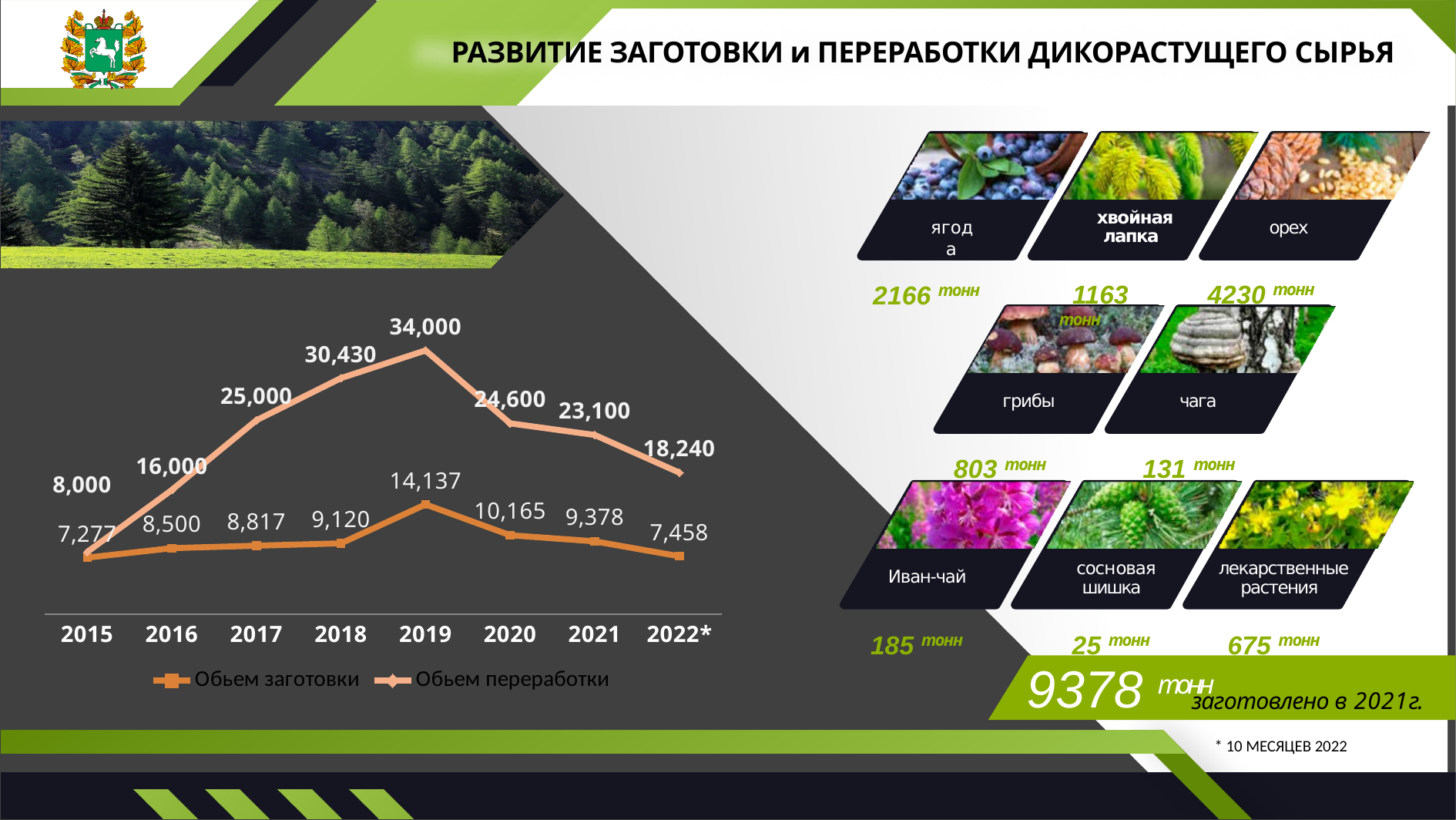
In which year is Объем заготовки highest? 2019 How many years are shown on the x axis of the chart? 8 How many series does the chart legend list? 2 What type of chart is shown on the slide? line chart Which is larger in 2016: Объем заготовки or Объем переработки? Объем переработки What is the difference in Объем заготовки between 2015 and 2018? 1,843 What is the difference between Объем переработки and Объем заготовки in 2019? 19,863 What is the value of Объем переработки in 2019? 34,000 What is the value of Объем переработки in 2022*? 18,240 What is the value of Объем заготовки in 2021? 9,378 In which year is Объем переработки lowest? 2015 How does Объем переработки change from 2019 to 2022*? It falls